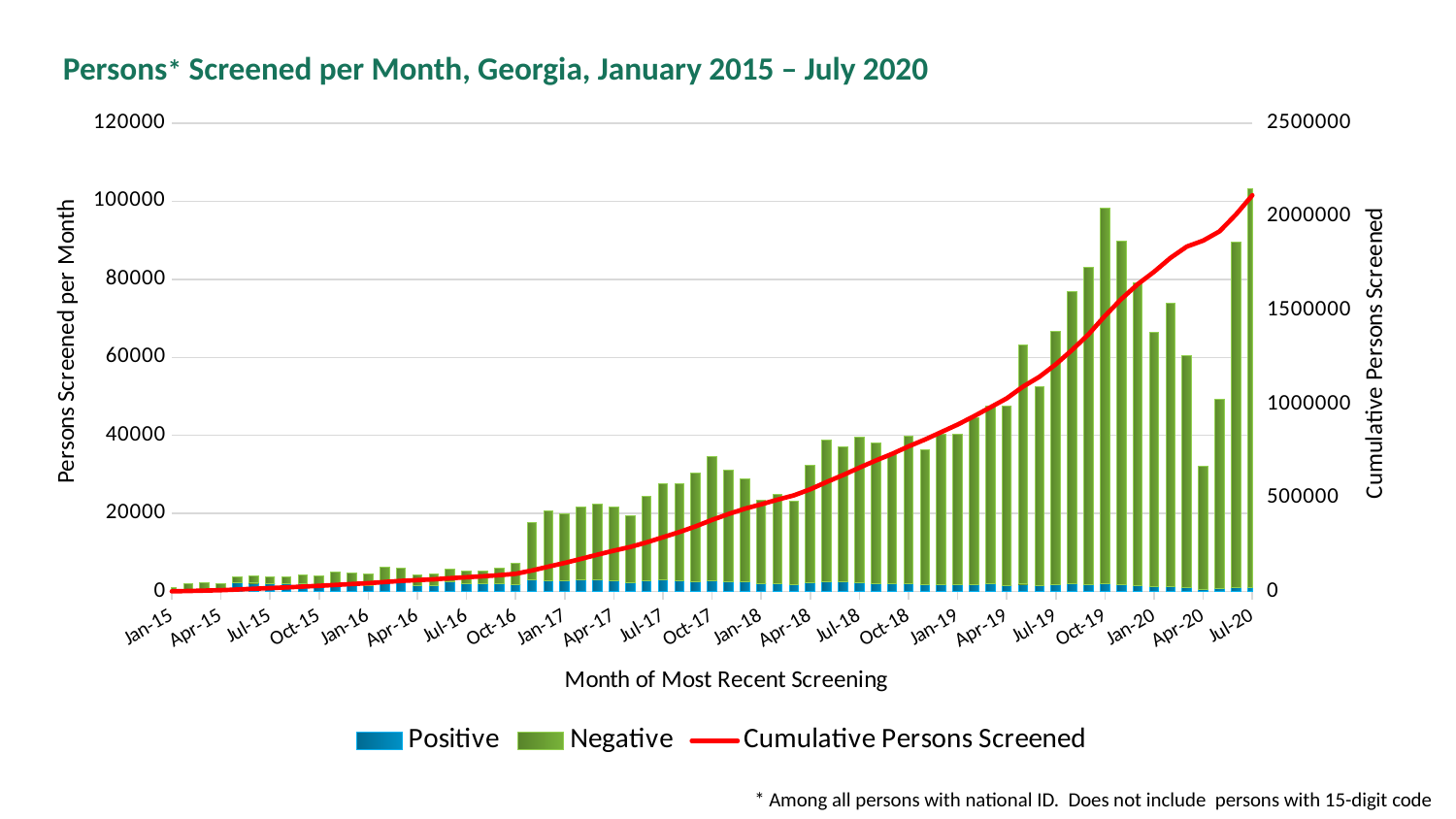
Does the Cumulative Persons Screened line rise or fall from Jan-15 to Jul-20? Rises How many series does the legend list? 3 Is the total bar for Apr-19 greater or less than 40000? greater Is the total bar for Jan-15 greater or less than 20000? less Is the total bar for Apr-20 greater or less than 40000? less What is the title of the chart? Persons* Screened per Month, Georgia, January 2015 – July 2020 Which month has the lowest total bar of persons screened? Jan-15 What kind of chart is shown on the slide? A bar chart with a line What is the label of the right-hand vertical axis? Cumulative Persons Screened Which month has the taller total bar, Jan-19 or Jan-20? Jan-20